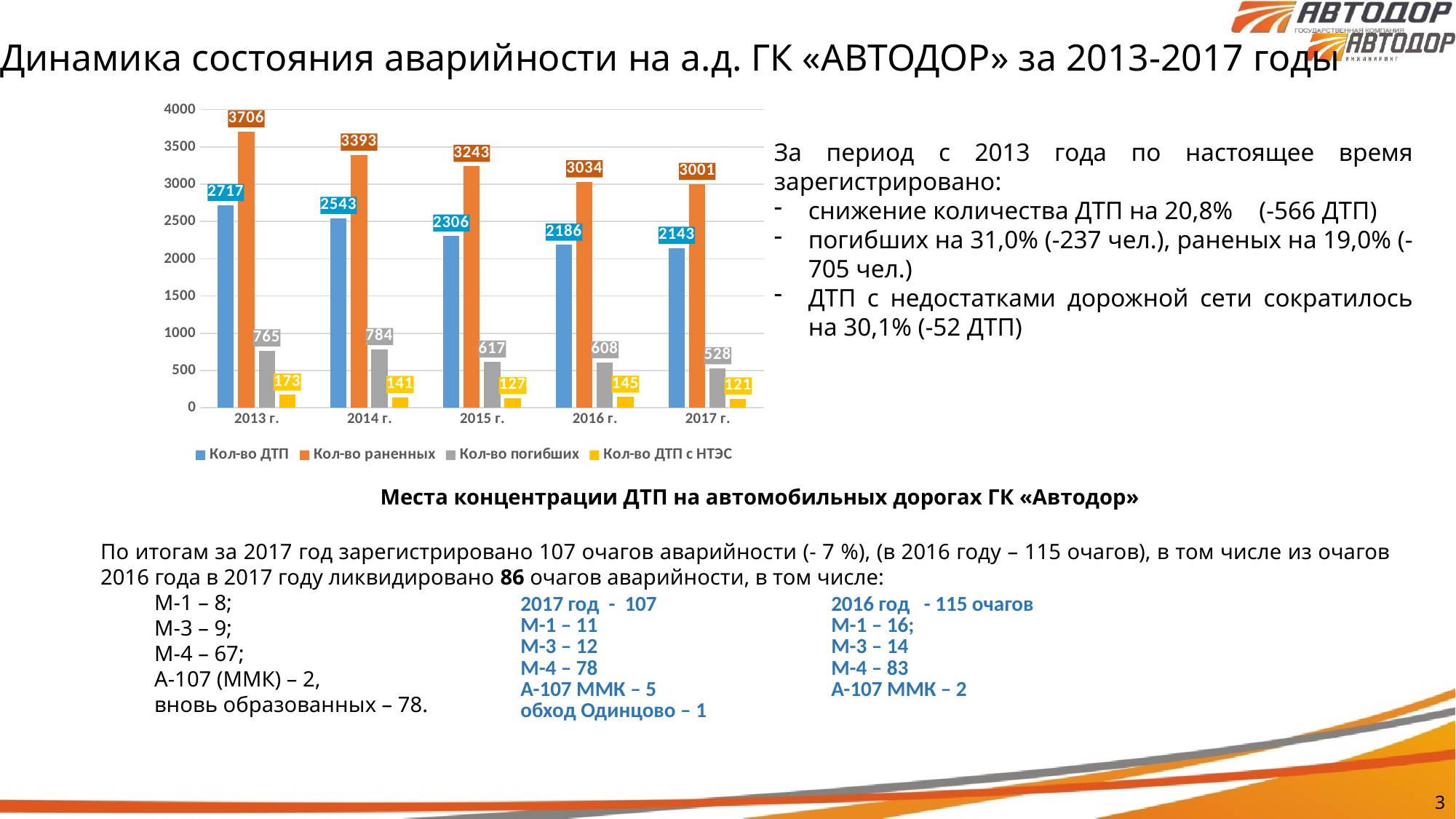
What is the value of Кол-во ДТП с НТЭС for 2016 г.? 145 How many series does the chart legend list? 4 What is the difference between Кол-во ДТП in 2013 г. and in 2017 г.? 574 Does Кол-во ДТП rise or fall from 2013 г. to 2017 г.? fall In which year is Кол-во раненных the highest? 2013 г. What is the value of Кол-во погибших for 2015 г.? 617 How many year categories are shown on the x axis of the chart? 5 What is the value of Кол-во раненных for 2017 г.? 3001 Which is larger: Кол-во погибших in 2013 г. or in 2014 г.? 2014 г. In which year is Кол-во ДТП с НТЭС the lowest? 2017 г. What is the value of Кол-во ДТП for 2013 г.? 2717 What type of chart is shown on the slide? bar chart